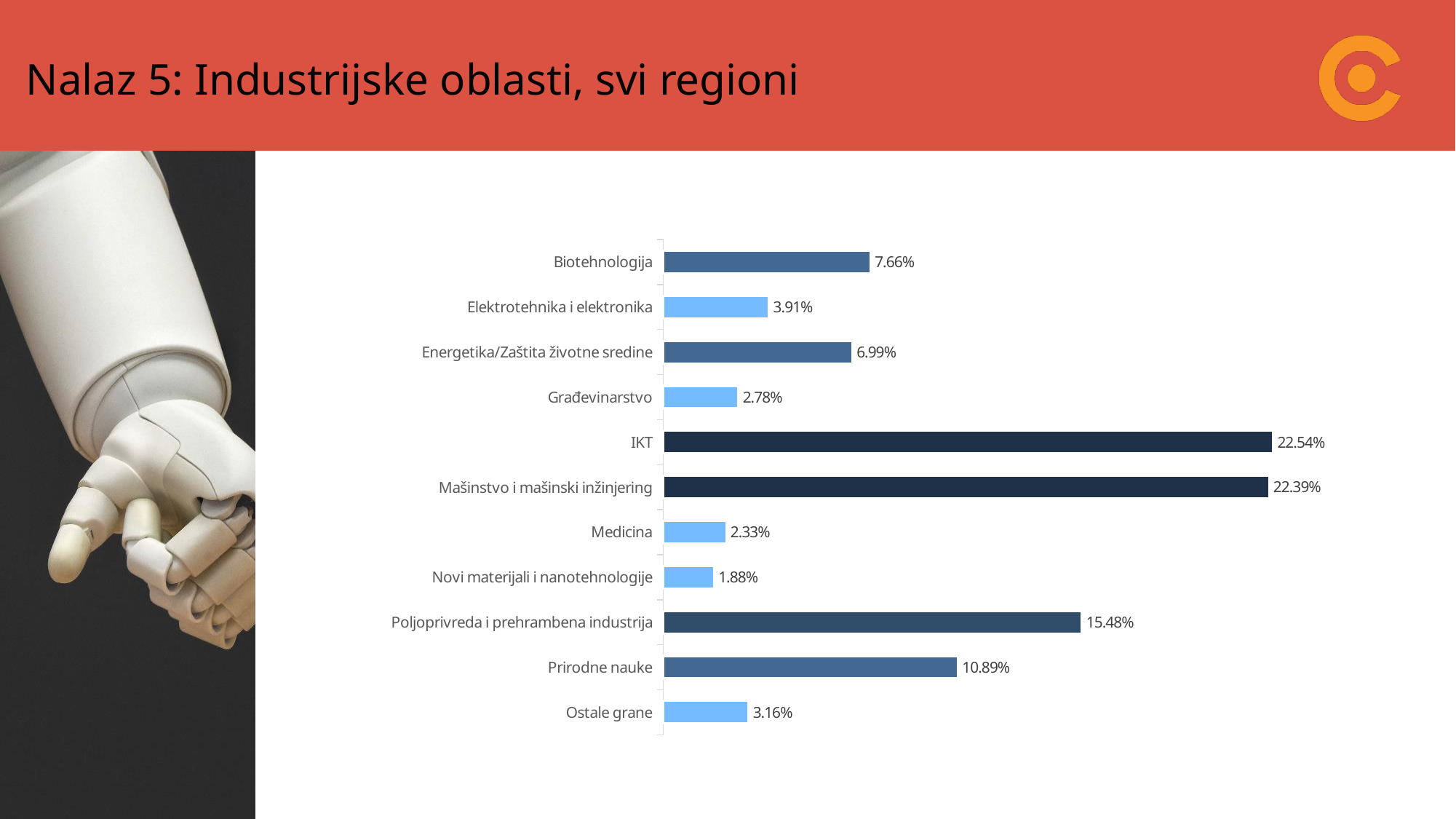
How many categories are shown in the chart? 11 What is the value for IKT? 22.54% Which category has the highest value? IKT What is the value for Poljoprivreda i prehrambena industrija? 15.48% What is the value for Građevinarstvo? 2.78% Which category has the lowest value? Novi materijali i nanotehnologije Which is larger, the value for Biotehnologija or the value for Energetika/Zaštita životne sredine? Biotehnologija What kind of chart is shown on the slide? Bar chart What is the title of the slide? Nalaz 5: Industrijske oblasti, svi regioni What is the difference between the values for Poljoprivreda i prehrambena industrija and Prirodne nauke? 4.59% What is the difference between the values for IKT and Mašinstvo i mašinski inžinjering? 0.15% What is the value for Prirodne nauke? 10.89%